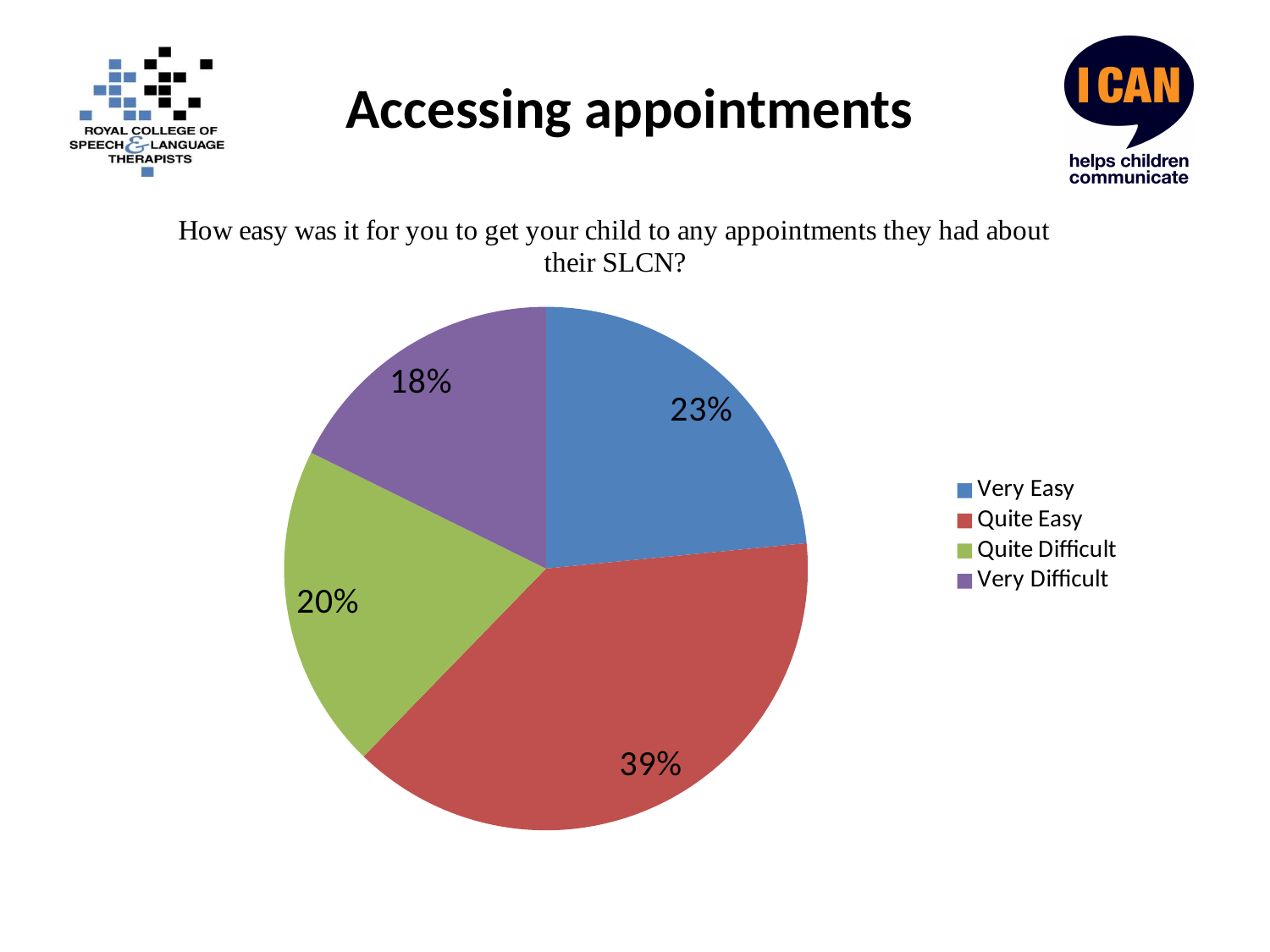
What is the difference in percentage points between Quite Easy and Very Easy? 16 What colour represents Quite Difficult in the pie chart? green What percentage of respondents said it was Quite Difficult? 20% What is the combined percentage for Very Easy and Quite Easy? 62% What percentage of respondents said it was Quite Easy? 39% Which is larger, the share for Quite Difficult or the share for Very Difficult? Quite Difficult How many categories does the legend list? 4 What kind of chart is shown on the slide? pie chart What percentage of respondents said it was Very Difficult? 18% Which response category has the largest share of the pie? Quite Easy Which response category has the smallest share of the pie? Very Difficult What percentage of respondents said it was Very Easy to get their child to appointments? 23%